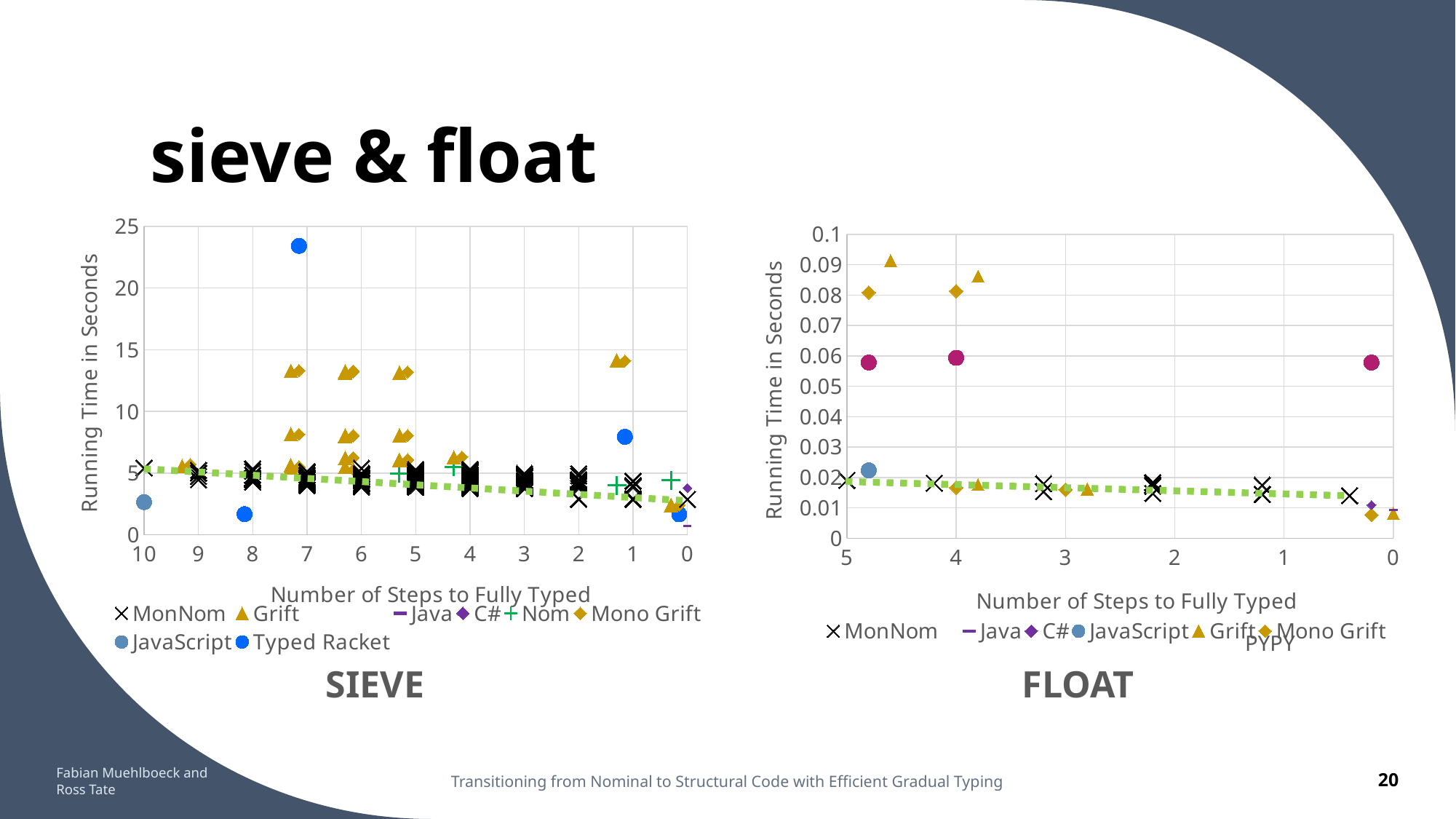
How many series does the legend of the FLOAT chart list? 7 In the SIEVE chart, is the highest Typed Racket value greater or less than 20? greater In the FLOAT chart, which series has the highest plotted point? Grift In the FLOAT chart, are the PyPy values greater or less than 0.05? greater What is the x-axis label of the SIEVE chart? Number of Steps to Fully Typed In the FLOAT chart, are the MonNom values greater or less than 0.03? less In the SIEVE chart, does the dotted trend line rise or fall moving from left to right? fall In the SIEVE chart, which series has the highest plotted point? Typed Racket How many series does the legend of the SIEVE chart list? 8 What is the y-axis label of the FLOAT chart? Running Time in Seconds What kind of chart is the SIEVE chart? scatter chart